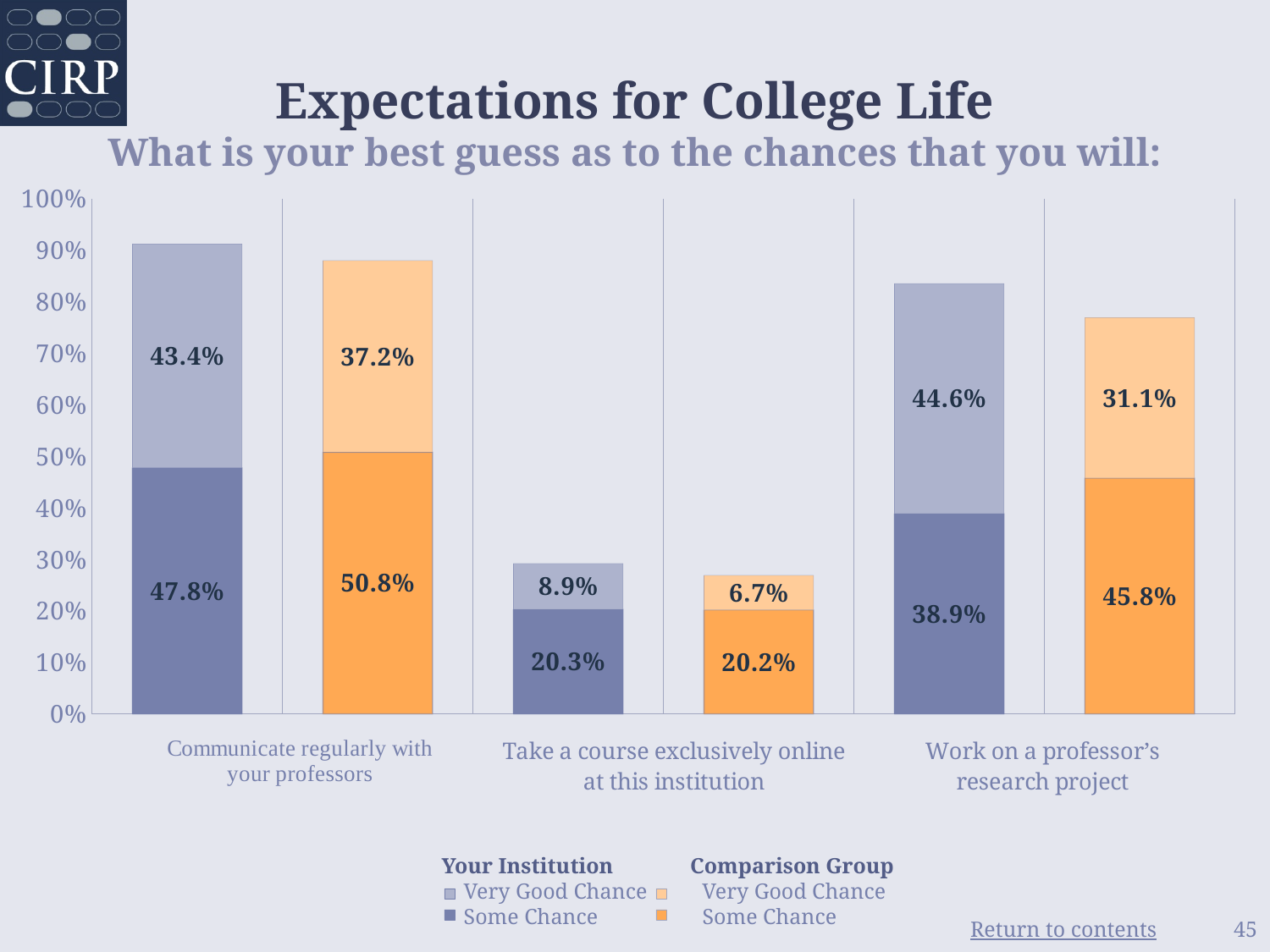
How many categories are shown on the x axis? 3 Which category has the highest Comparison Group 'Very Good Chance' value? Communicate regularly with your professors Which category has the lowest Your Institution 'Some Chance' value? Take a course exclusively online at this institution Which is larger for 'Communicate regularly with your professors': the Your Institution 'Some Chance' value or the Comparison Group 'Some Chance' value? Comparison Group 'Some Chance' (50.8%) What kind of chart is shown on the slide? Stacked bar chart What is the Comparison Group 'Very Good Chance' value for 'Take a course exclusively online at this institution'? 6.7% What is the total of the Comparison Group stacked bar for 'Take a course exclusively online at this institution'? 26.9% What is the difference between the Your Institution and Comparison Group 'Very Good Chance' values for 'Work on a professor's research project'? 13.5% What is the Comparison Group 'Some Chance' value for 'Work on a professor's research project'? 45.8% What is the total of the Your Institution stacked bar for 'Communicate regularly with your professors'? 91.2% What is the Your Institution 'Very Good Chance' value for 'Communicate regularly with your professors'? 43.4% How many series does the legend list? 4